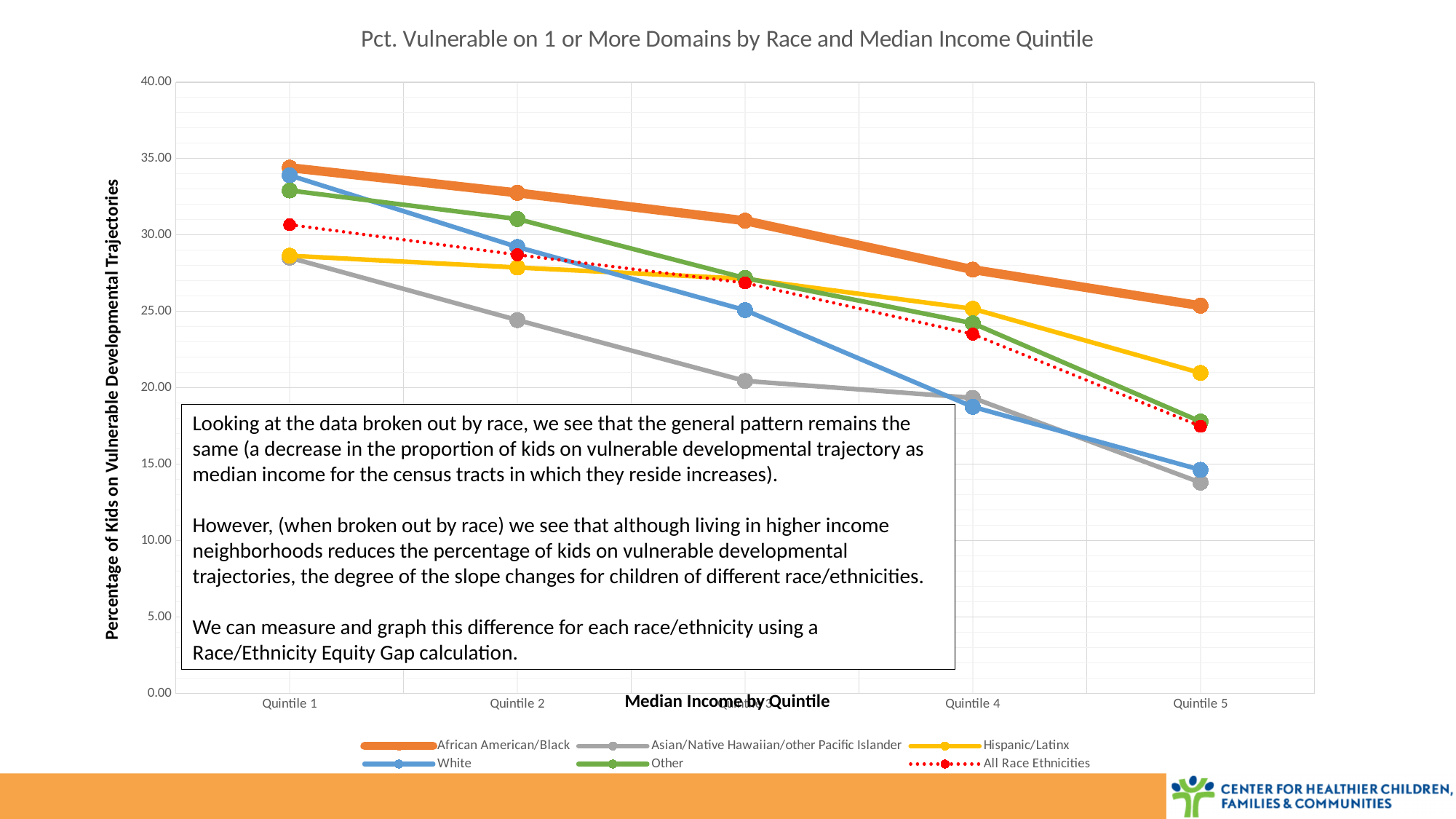
Which series has the highest value at Quintile 5? African American/Black Which series has the lowest value at Quintile 3? Asian/Native Hawaiian/other Pacific Islander Is the value for African American/Black at Quintile 1 greater or less than 30.00? greater At Quintile 4, which is larger: the value for Hispanic/Latinx or the value for White? Hispanic/Latinx How many quintile categories are plotted along the x axis? 5 How many series does the legend list? 6 What kind of chart is shown on the slide? line chart Is the value for Asian/Native Hawaiian/other Pacific Islander at Quintile 3 greater or less than 25.00? less Which series is drawn as a red dotted line? All Race Ethnicities Is the value for White at Quintile 4 greater or less than 20.00? less What is the title of the chart? Pct. Vulnerable on 1 or More Domains by Race and Median Income Quintile Does the African American/Black line rise or fall from Quintile 1 to Quintile 5? fall